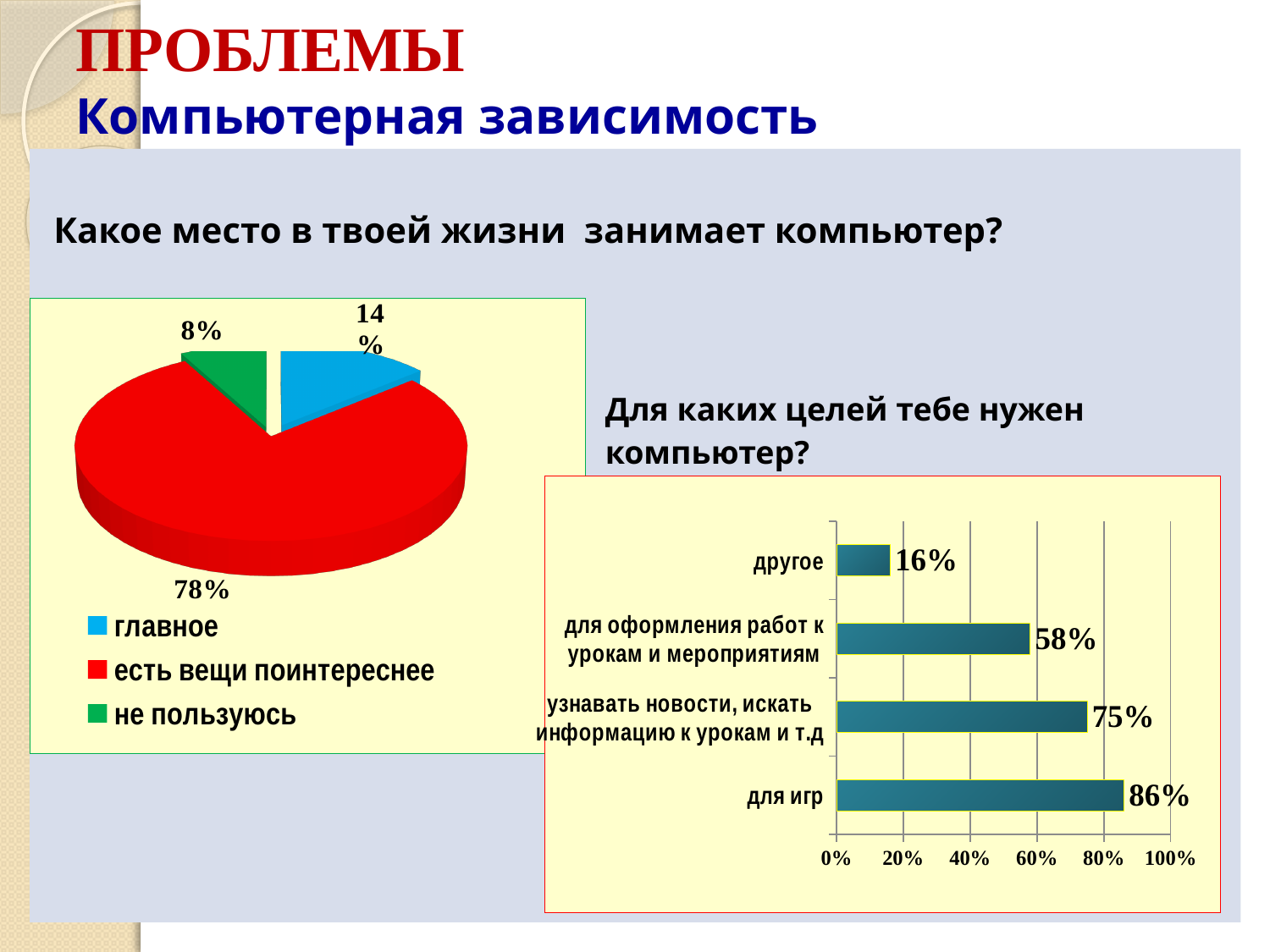
In the pie chart on the left, what share of respondents answered "главное"? 14% In the bar chart on the right, what is the value for "другое"? 16% In the pie chart on the left, how many categories does the legend list? 3 In the pie chart on the left, which category has the smallest slice? не пользуюсь In the bar chart on the right, which category has the lowest value? другое In the pie chart on the left, which category has the largest slice? есть вещи поинтереснее In the bar chart on the right, which is larger: the value for "узнавать новости, искать информацию к урокам и т.д" or for "для оформления работ к урокам и мероприятиям"? узнавать новости, искать информацию к урокам и т.д In the pie chart on the left, what colour is the slice for "не пользуюсь"? green In the pie chart on the left, what share of respondents answered "есть вещи поинтереснее"? 78% In the bar chart on the right, what is the difference between the values for "для игр" and "для оформления работ к урокам и мероприятиям"? 28% In the bar chart on the right, what is the value for "для игр"? 86% What kind of chart is the chart on the right? bar chart